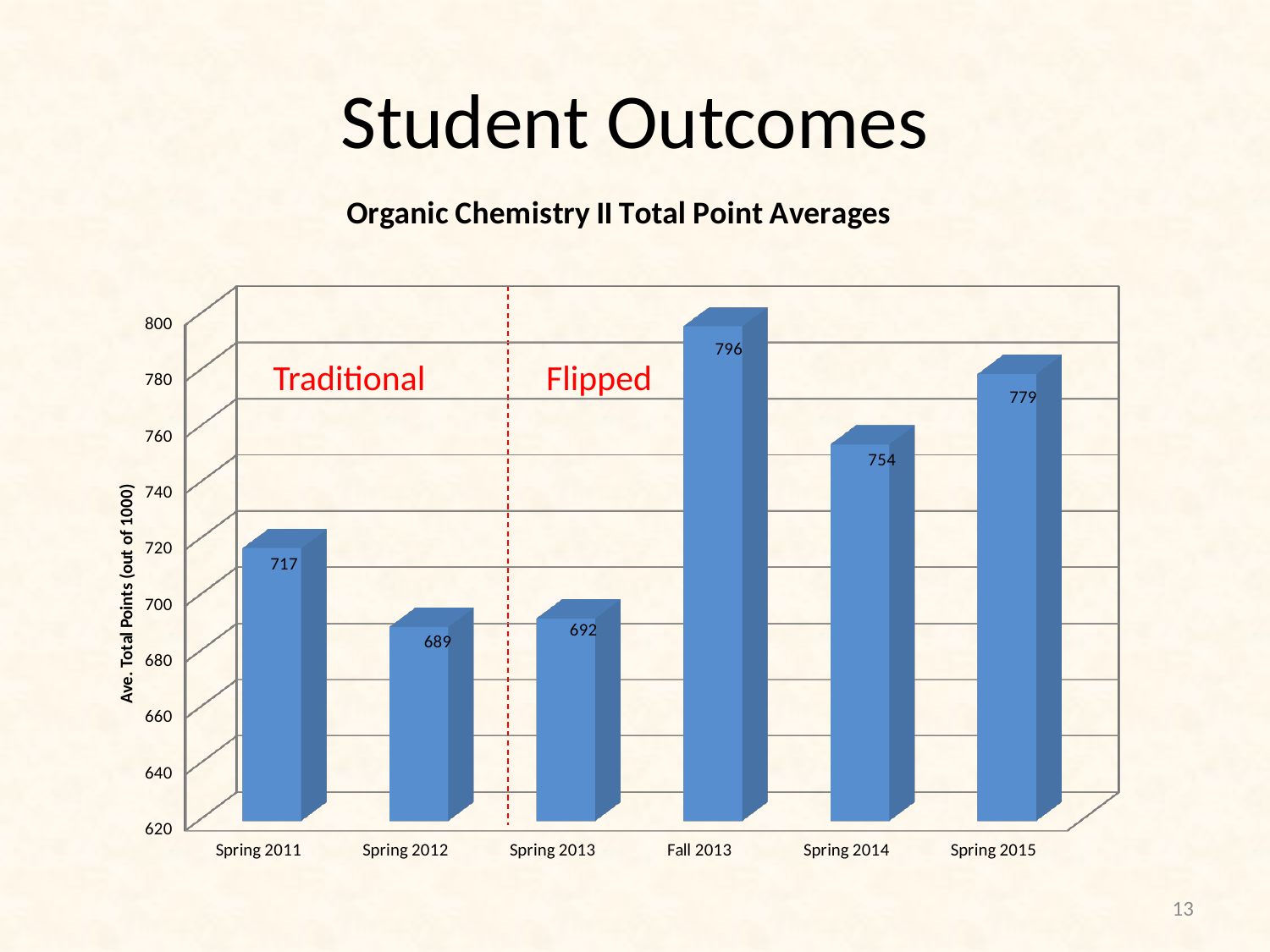
What is the average total points value for Spring 2015? 779 Which semester has the highest average total points? Fall 2013 Is the value for Spring 2013 greater or less than 700? less What is the difference in average total points between Spring 2011 and Spring 2012? 28 How many semesters are shown on the x axis? 6 Which has a higher average total points, Spring 2014 or Spring 2015? Spring 2015 Which semester has the lowest average total points? Spring 2012 What is the title of the chart? Organic Chemistry II Total Point Averages What kind of chart is shown on the slide? Bar chart What is the average total points value for Spring 2012? 689 What is the difference in average total points between Fall 2013 and Spring 2013? 104 What is the average total points value for Fall 2013? 796